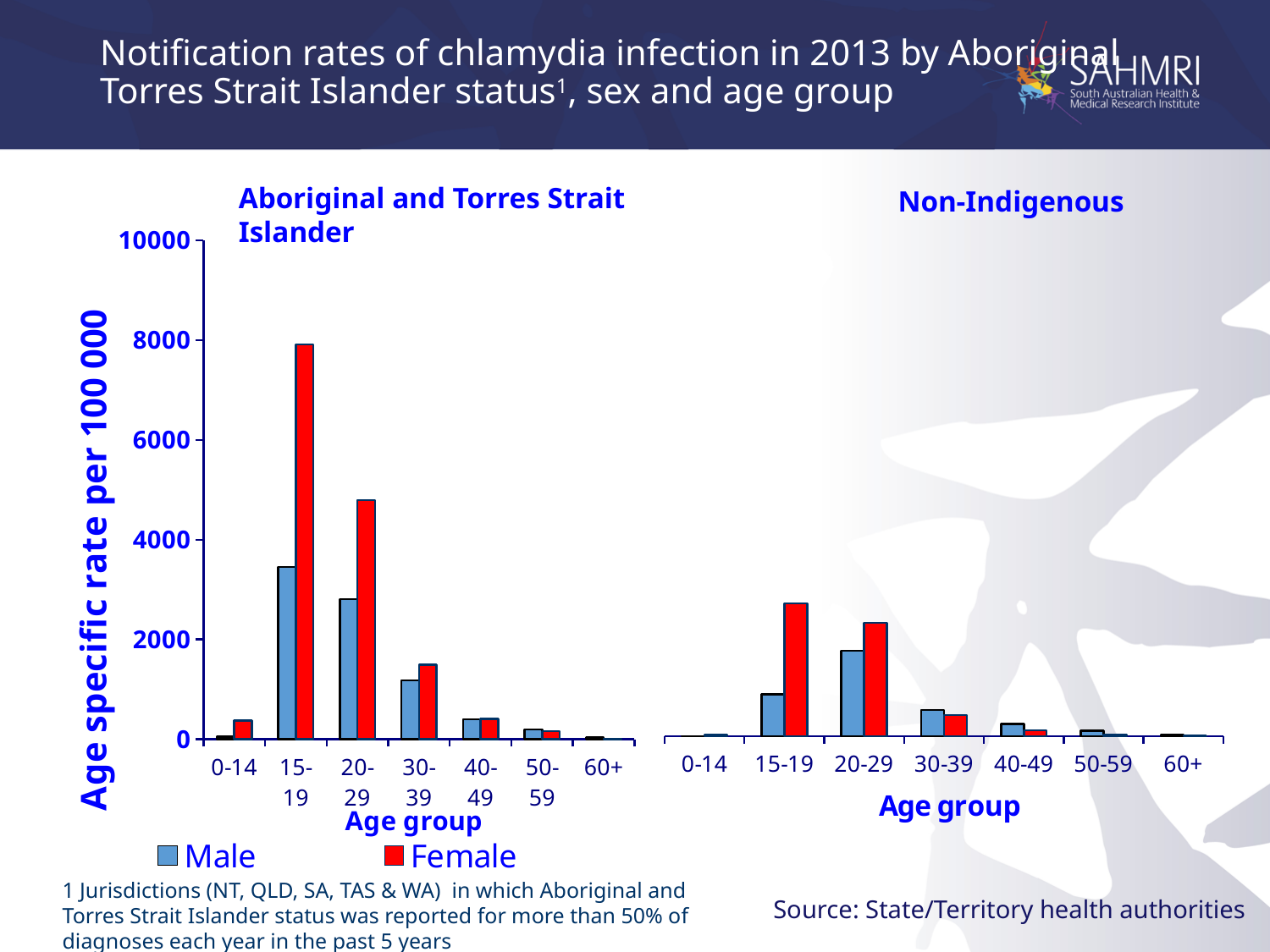
In the Non-Indigenous chart, which age group has the highest Female rate? 15-19 In the Aboriginal and Torres Strait Islander chart, do the Female values rise or fall from the 15-19 age group to the 60+ age group? fall In the Non-Indigenous chart, which age group has the highest Male rate? 20-29 In the Aboriginal and Torres Strait Islander chart, is the Male value for 15-19 greater or less than 4000? less In the Aboriginal and Torres Strait Islander chart, which age group has the highest Female rate? 15-19 What kind of chart is used on this slide to show the notification rates? Bar chart What is the label on the vertical axis of the charts? Age specific rate per 100 000 In the Aboriginal and Torres Strait Islander chart, which is larger for the 20-29 age group, Male or Female? Female How many series does the legend list? 2 In the Aboriginal and Torres Strait Islander chart, how many age groups are shown on the x axis? 7 In the Aboriginal and Torres Strait Islander chart, is the Female value for 15-19 greater or less than 6000? greater